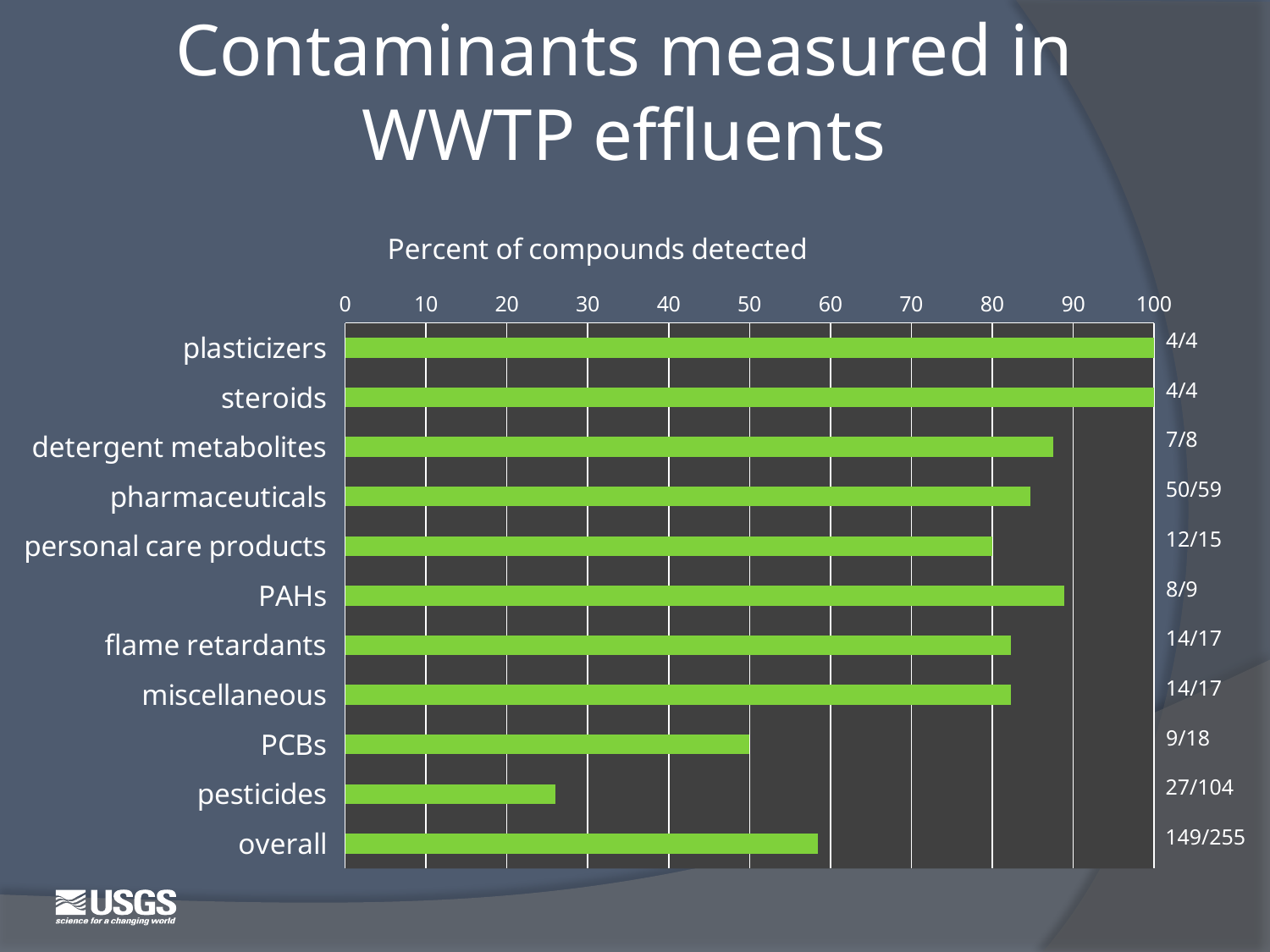
What is the percent of compounds detected for PCBs? 50 What is the percent of compounds detected for plasticizers? 100 What is the title of the chart? Percent of compounds detected Is the value for overall greater or less than 50? greater Is the value for PAHs greater or less than 80? greater What kind of chart is shown on the slide? bar chart What is the percent of compounds detected for personal care products? 80 How many contaminant categories are plotted in the chart? 11 Which has a higher percent of compounds detected, PCBs or pesticides? PCBs Which category has the lowest percent of compounds detected? pesticides Is the value for pesticides greater or less than 30? less What fraction is printed next to the overall bar? 149/255